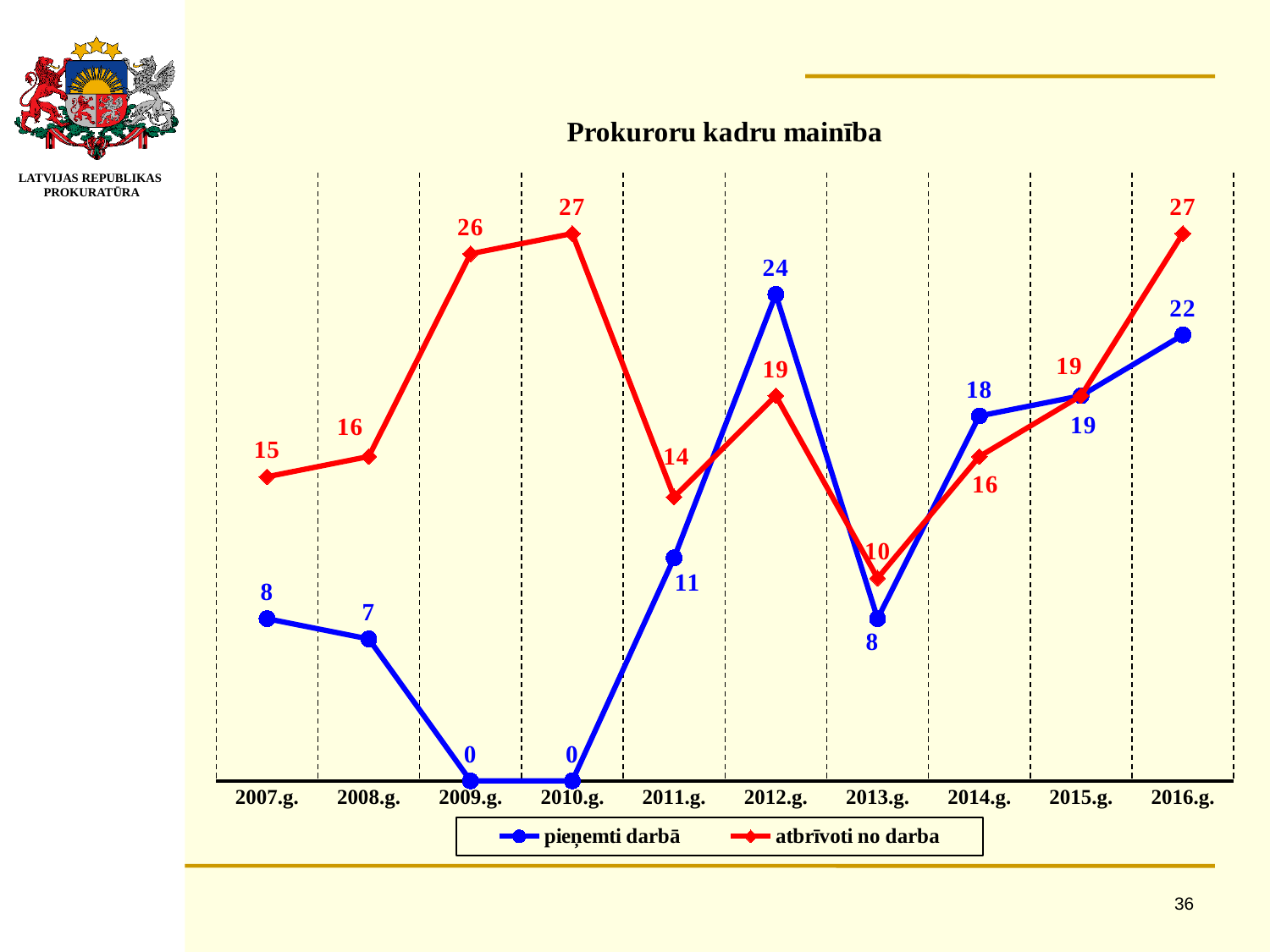
What is the difference between "atbrīvoti no darba" and "pieņemti darbā" in 2010.g.? 27 What is the value for "atbrīvoti no darba" in 2009.g.? 26 What kind of chart is shown on the slide? line chart How many years are shown on the x axis? 10 In which year is "atbrīvoti no darba" lowest? 2013.g. What is the value for "pieņemti darbā" in 2012.g.? 24 What is the value for "pieņemti darbā" in 2016.g.? 22 How many series does the legend list? 2 In which year is "pieņemti darbā" highest? 2012.g. What is the title of the chart? Prokuroru kadru mainība Which series has the larger value in 2012.g., "pieņemti darbā" or "atbrīvoti no darba"? pieņemti darbā Does "pieņemti darbā" rise or fall from 2013.g. to 2016.g.? rise